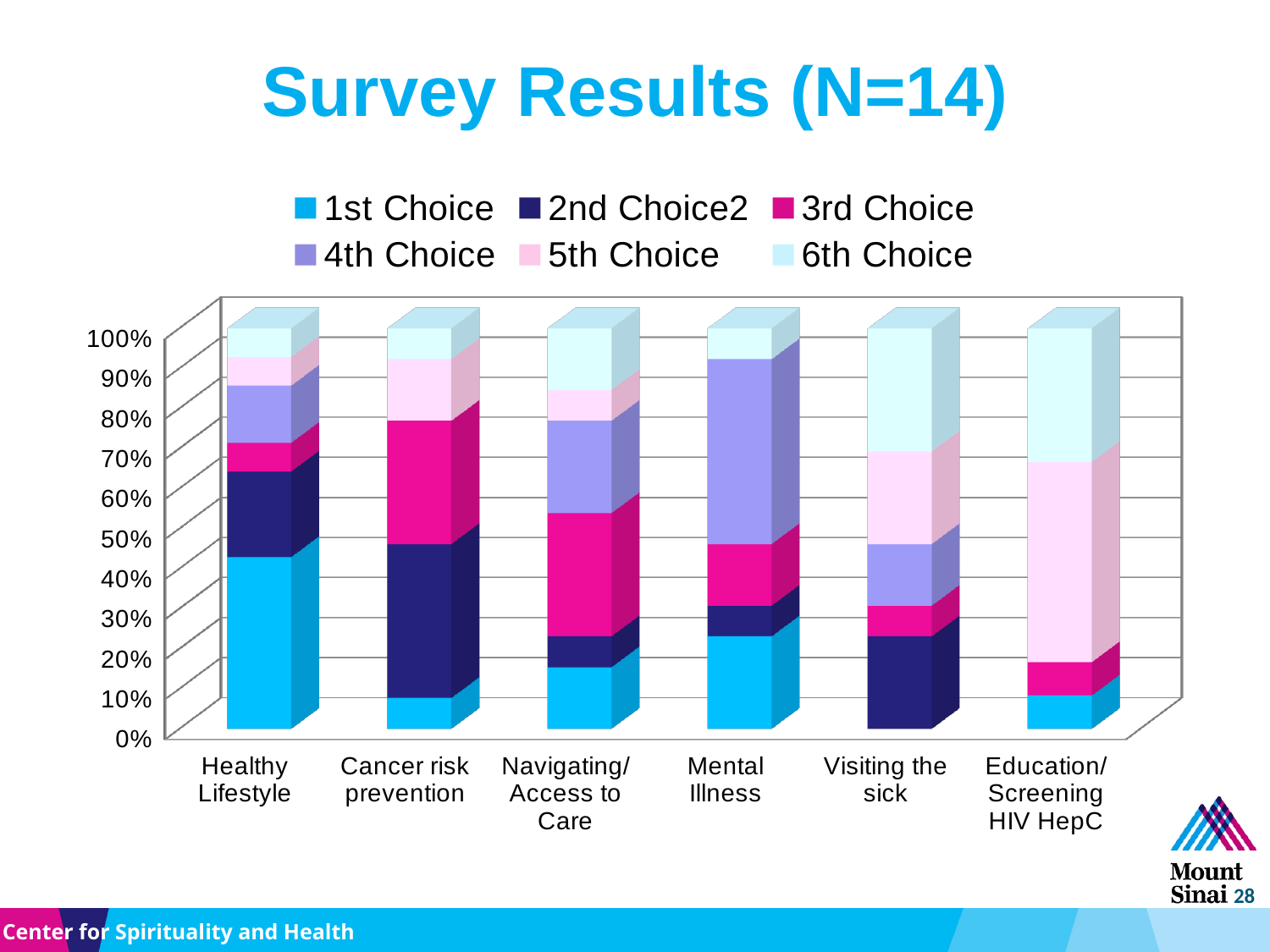
What kind of chart is shown on the slide? Stacked bar chart Which legend entry is shown in the darkest blue colour? 2nd Choice2 How many categories are shown along the x axis? 6 Which category has the largest 5th Choice share? Education/Screening HIV HepC How many series does the legend list? 6 What is the title of the chart? Survey Results (N=14) What does each stacked bar total? 100% Which is larger, the 1st Choice share for Healthy Lifestyle or for Mental Illness? Healthy Lifestyle Which category has the largest 1st Choice share? Healthy Lifestyle Is the 5th Choice share for Education/Screening HIV HepC greater or less than 40%? greater Which category has the largest 4th Choice share? Mental Illness Is the 1st Choice share for Healthy Lifestyle greater or less than 30%? greater